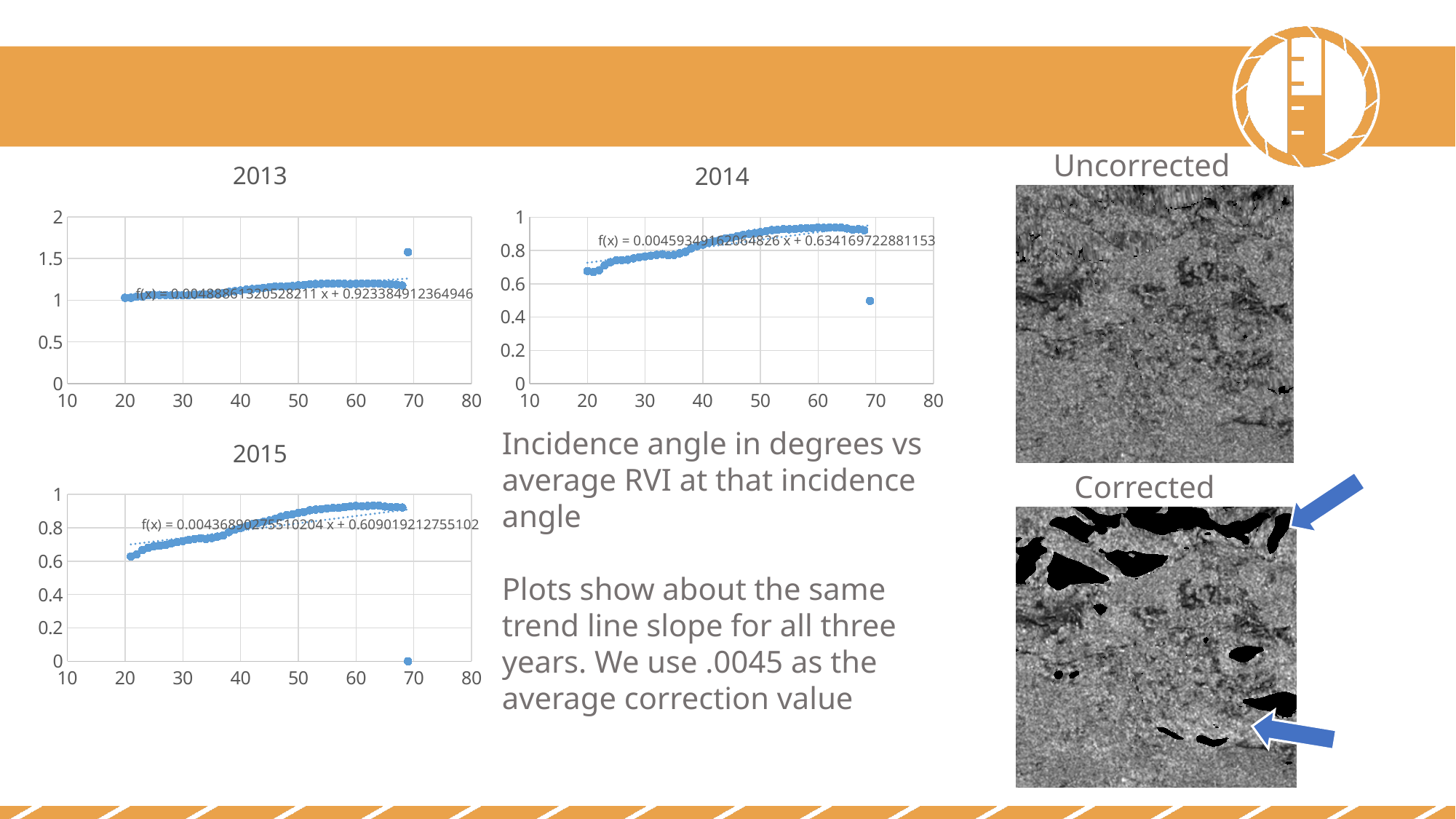
In the 2015 chart, is the isolated point near an incidence angle of 69 greater or less than 0.2? less In the 2014 chart, is the isolated point near an incidence angle of 69 greater or less than 0.6? less What kind of chart is the 2013 chart? scatter chart In the 2014 chart, which is larger: the value at an incidence angle of 60 or the value at an incidence angle of 20? 60 In the 2014 chart, do the plotted values generally rise or fall as the incidence angle increases from 20 to 60? rise In the 2015 chart, is the value at an incidence angle of 20 greater or less than 0.8? less Which of the three charts has a y axis that goes up to 2? 2013 In the 2014 chart, what is the trend line equation printed on the plot? f(x) = 0.00459349162064826 x + 0.634169722881153 In the 2015 chart, what is the slope of the trend line shown in the printed equation? 0.00436890275510204 How many charts are shown on the slide? 3 In the 2015 chart, do the plotted values generally rise or fall as the incidence angle increases from 20 to 60? rise